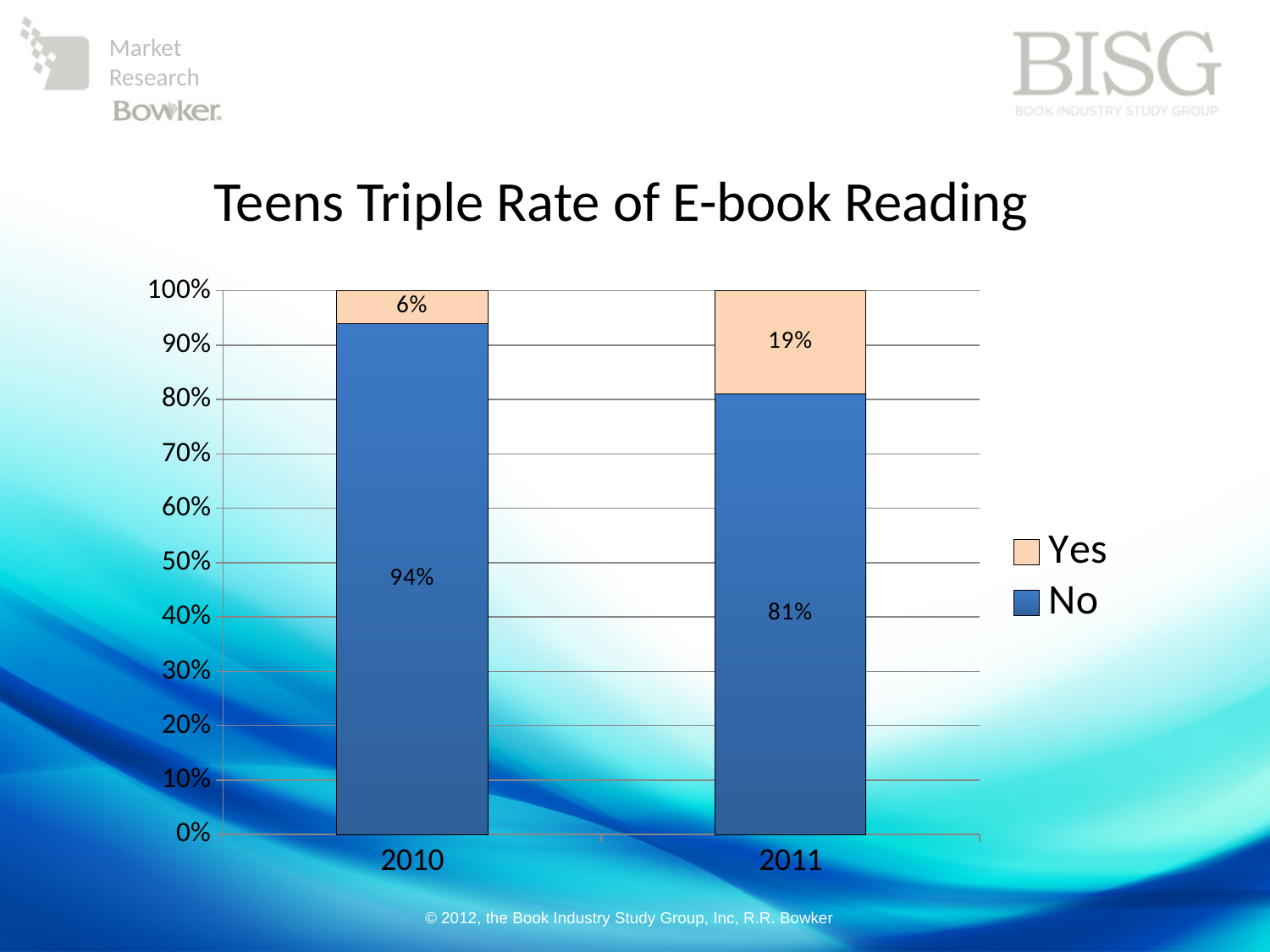
Which year has the higher value for Yes? 2011 What is the value for Yes in 2010? 6% What is the value for No in 2011? 81% What kind of chart is shown? stacked bar chart Is the No value for 2010 larger or smaller than the No value for 2011? larger What is the value for No in 2010? 94% Which year has the lower value for No? 2011 How many series does the legend list? 2 How many years are shown on the x axis? 2 What is the title of the chart? Teens Triple Rate of E-book Reading What is the value for Yes in 2011? 19% What is the difference between the Yes values for 2011 and 2010? 13%